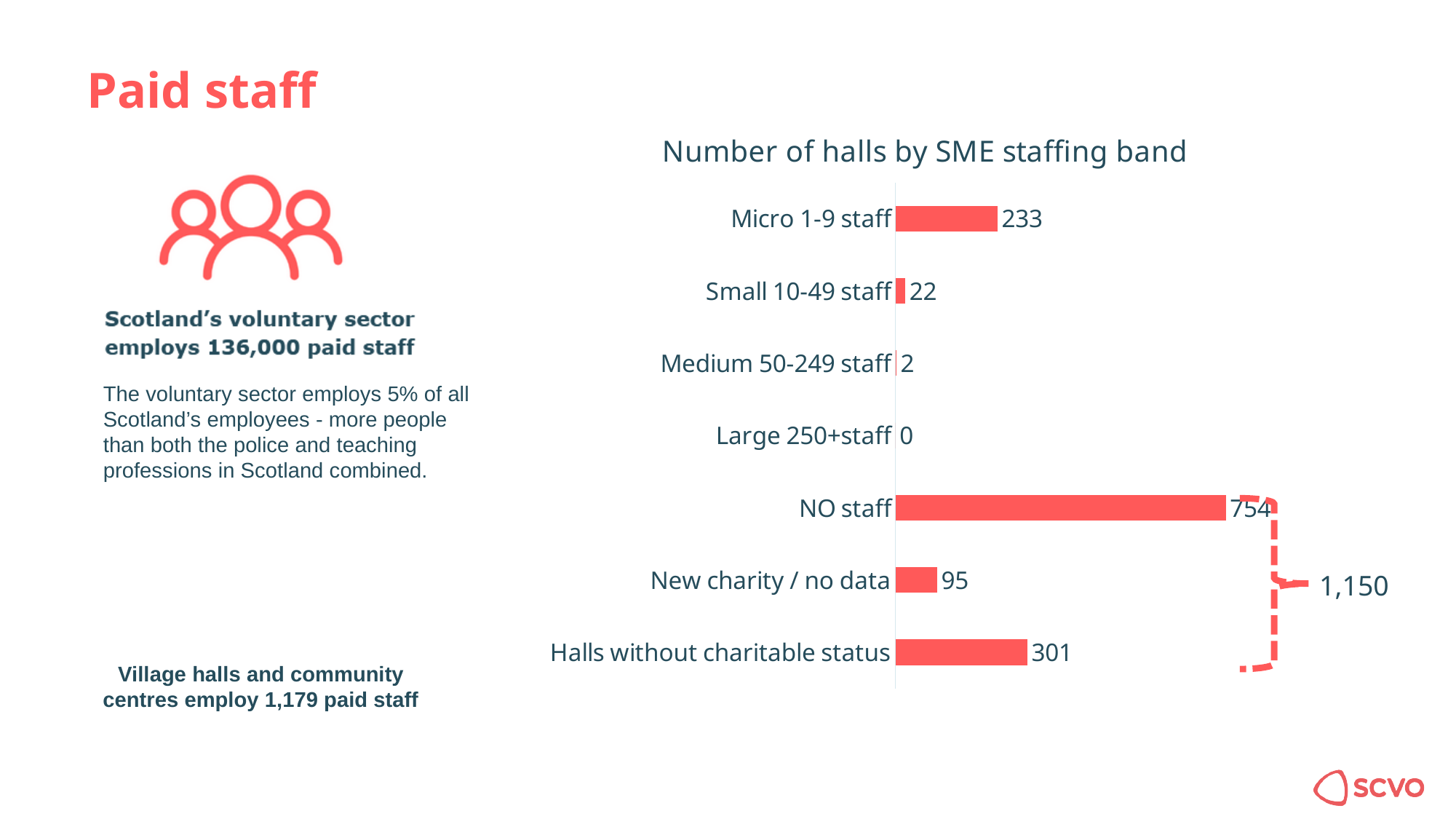
Which category has the highest number of halls? NO staff What is the value for Halls without charitable status? 301 What is the number of halls with NO staff? 754 What is the number of halls in the Medium 50-249 staff band? 2 What is the title of the chart? Number of halls by SME staffing band What is the number of halls in the Small 10-49 staff band? 22 How many categories are shown in the chart? 7 What is the difference between the NO staff value and the Micro 1-9 staff value? 521 What kind of chart is shown on the slide? Bar chart What is the number of halls in the Micro 1-9 staff band? 233 Which is larger, Halls without charitable status or New charity / no data? Halls without charitable status Which category has the lowest number of halls? Large 250+staff